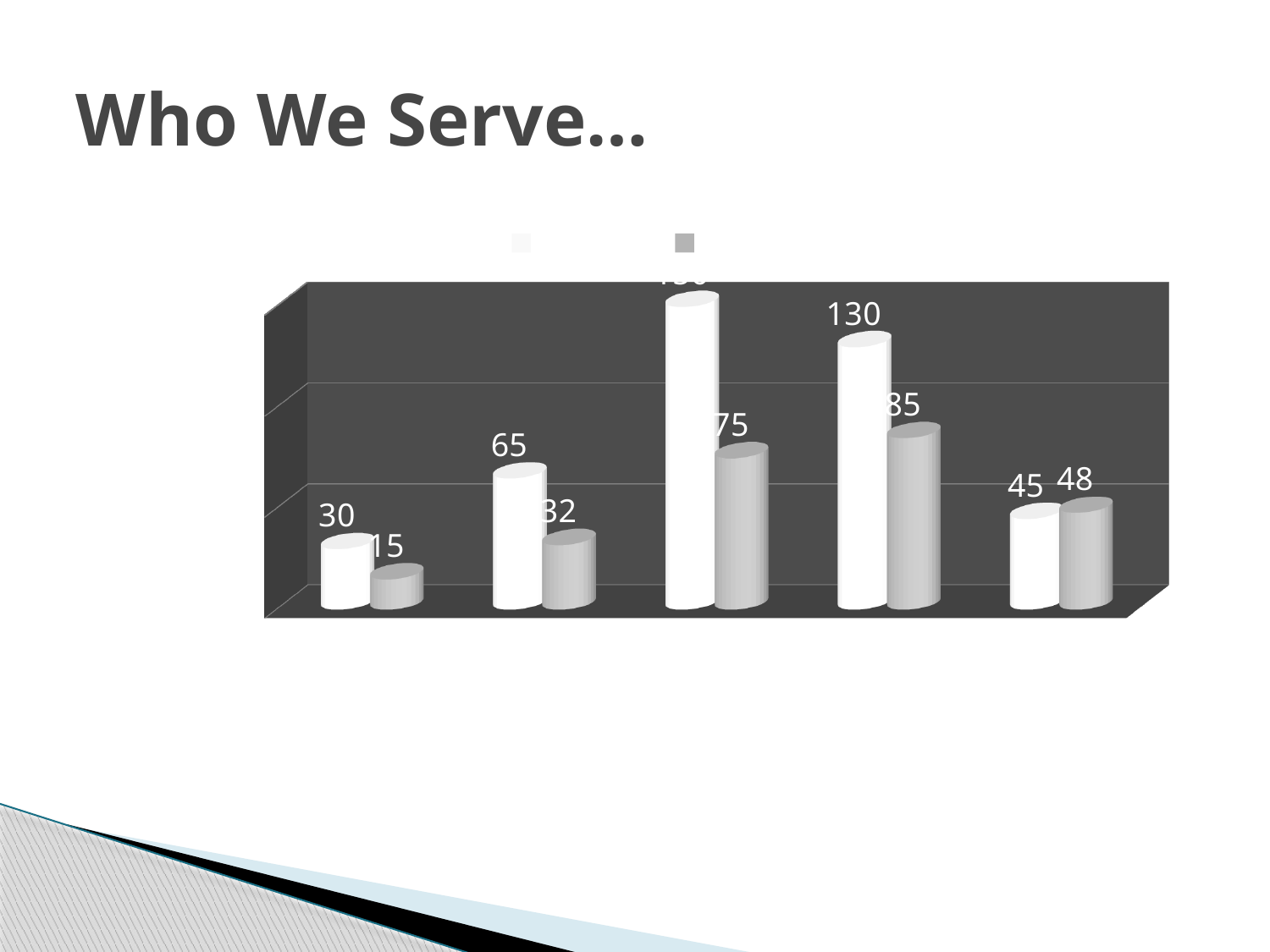
What kind of chart is shown on the slide? bar chart What is the value of the white bar in the second group from the left? 65 What is the difference between the white bar (130) and the grey bar (85) in the fourth group from the left? 45 How many groups of bars are plotted in the chart? 5 How many series does the chart's legend list? 2 What is the value of the grey bar in the fourth group from the left? 85 What is the value of the white bar in the first group from the left? 30 What is the difference between the white bar and the grey bar in the second group from the left? 33 Which group of bars has the lowest white bar? the first group from the left In the fifth group from the left, which bar is larger, the white bar or the grey bar? the grey bar Which group of bars has the highest grey bar? the fourth group from the left What is the value of the grey bar in the first group from the left? 15